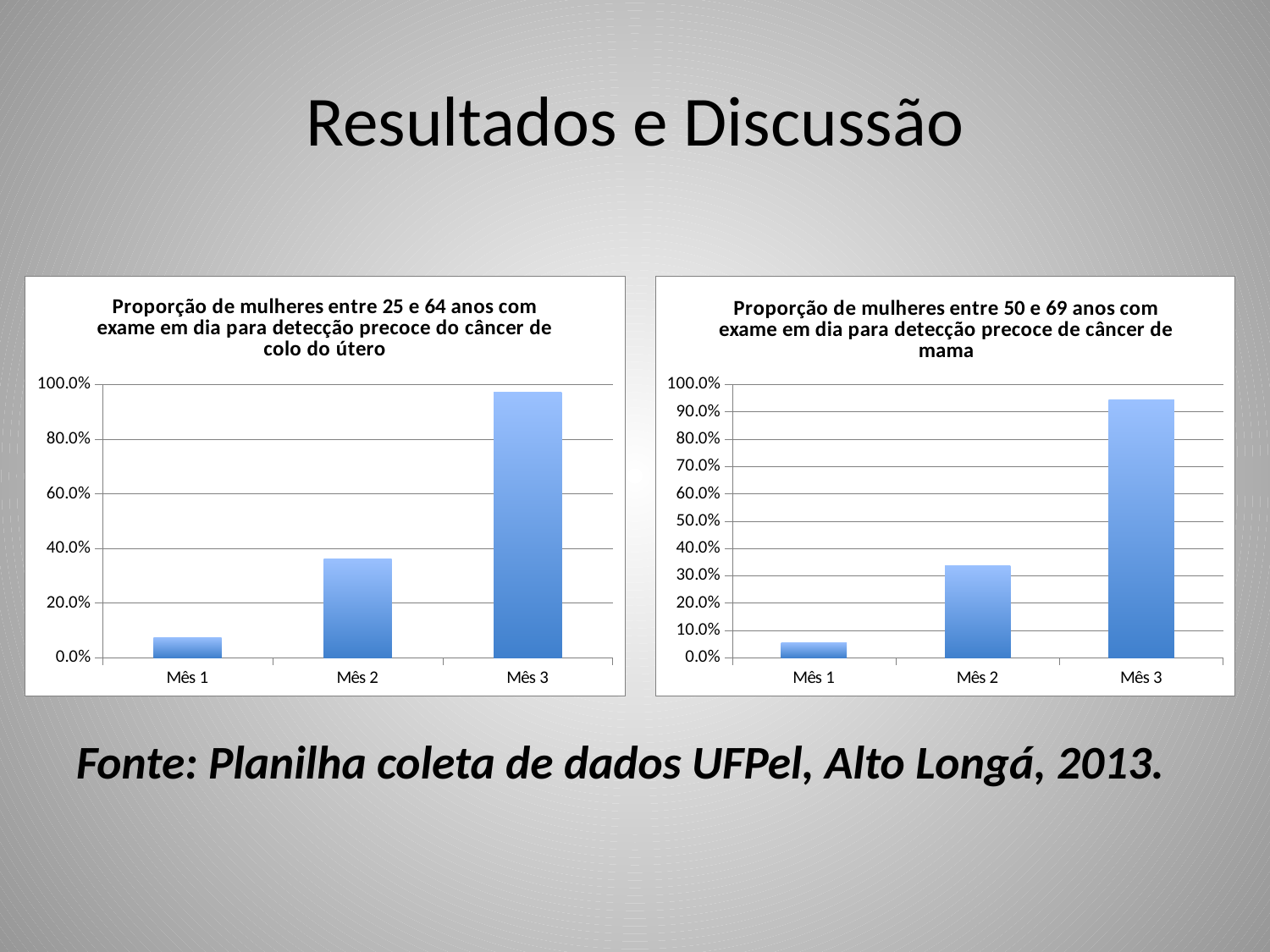
In the left chart (câncer de colo do útero), do the values rise or fall from Mês 1 to Mês 3? rise In the left chart (câncer de colo do útero), which month has the highest value? Mês 3 In the right chart (câncer de mama), which month has the highest value? Mês 3 In the left chart (câncer de colo do útero), is the value for Mês 1 greater or less than 20.0%? less In the left chart (câncer de colo do útero), which month has the lowest value? Mês 1 In the left chart (câncer de colo do útero), which is larger, the value for Mês 2 or the value for Mês 3? Mês 3 What kind of chart is the left chart, titled 'Proporção de mulheres entre 25 e 64 anos com exame em dia para detecção precoce do câncer de colo do útero'? bar chart In the right chart (câncer de mama), which month has the lowest value? Mês 1 In the right chart (câncer de mama), is the value for Mês 3 greater or less than 90.0%? greater What is the title of the right chart? Proporção de mulheres entre 50 e 69 anos com exame em dia para detecção precoce de câncer de mama How many categories are shown on the x axis of the right chart (câncer de mama)? 3 In the right chart (câncer de mama), is the value for Mês 2 greater or less than 30.0%? greater